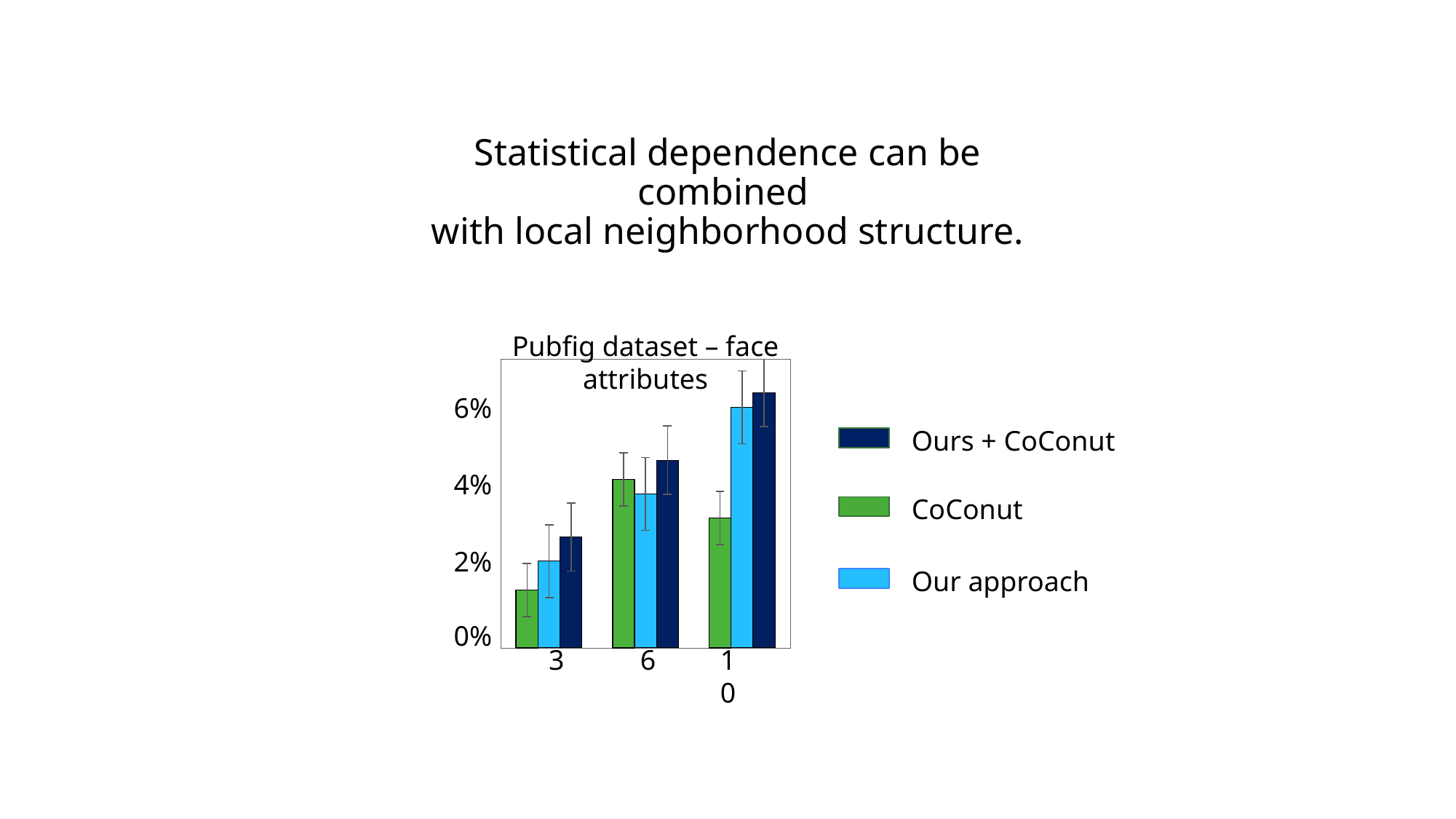
What is the title of the chart? Pubfig dataset – face attributes Which series is drawn in green in the chart? CoConut What kind of chart is shown on the slide? bar chart Is the value for Ours + CoConut at category 6 greater or less than 4%? greater At category 10, which is larger: Our approach or CoConut? Our approach Is the value for CoConut at category 3 greater or less than 2%? less At which category does Ours + CoConut reach its highest value? 10 How many categories are shown along the x axis of the chart? 3 Do the values for Ours + CoConut rise or fall as the x axis goes from 3 to 10? rise Is the value for CoConut at category 10 greater or less than 4%? less How many series does the chart legend list? 3